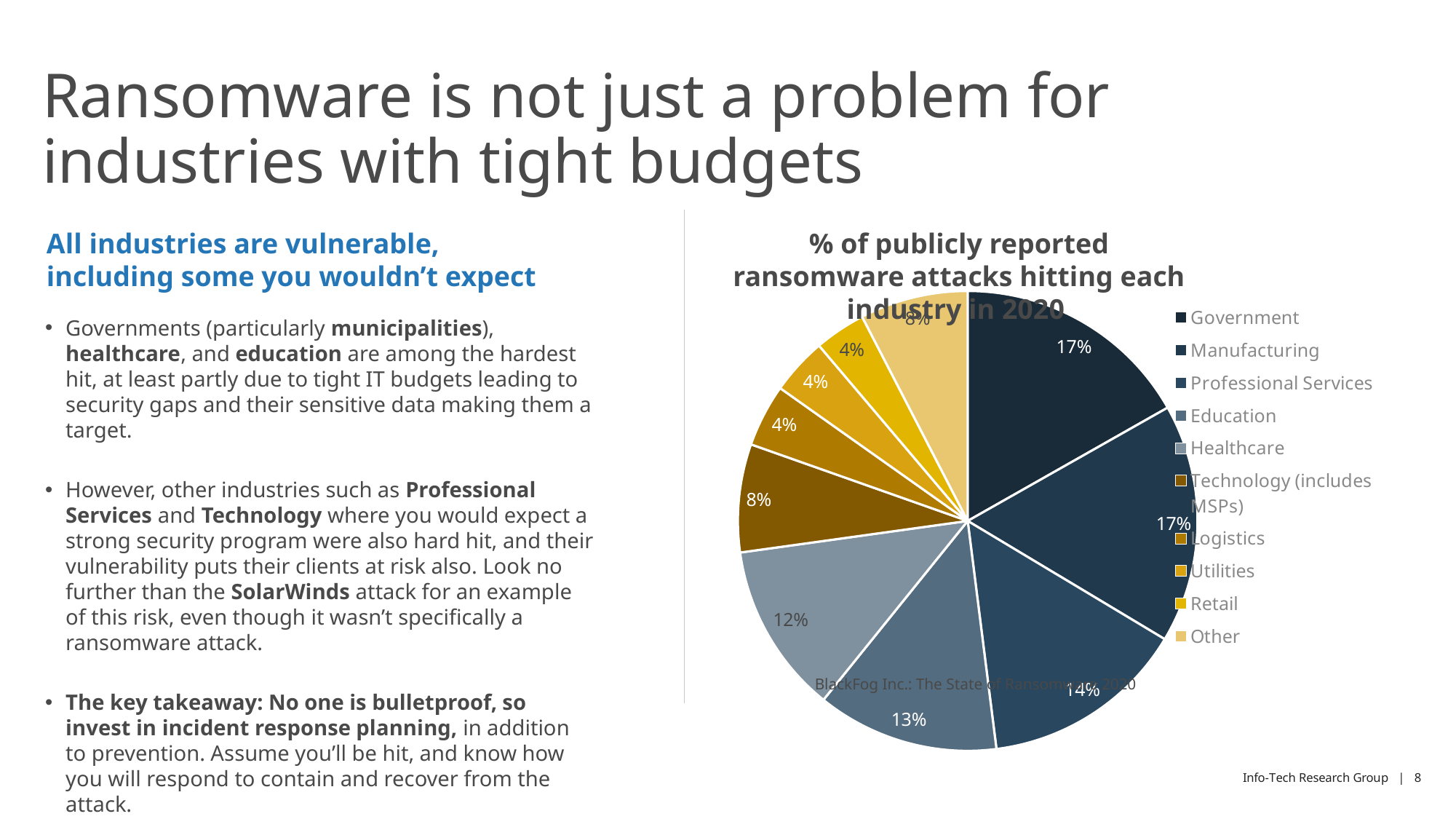
What percentage of attacks hit Education? 13% What is the value shown for Technology (includes MSPs)? 8% What share of the pie does Healthcare account for? 12% What kind of chart is shown on the slide? Pie chart How many industry categories does the pie chart show? 10 What is the value for Professional Services? 14% What is the value for Manufacturing? 17% What is the difference between the Manufacturing share and the Technology (includes MSPs) share? 9% What is the difference between the Government share and the Healthcare share? 5% What is the title of the chart? % of publicly reported ransomware attacks hitting each industry in 2020 What percentage of publicly reported ransomware attacks in 2020 hit Government? 17% Which has a larger share, Education or Healthcare? Education